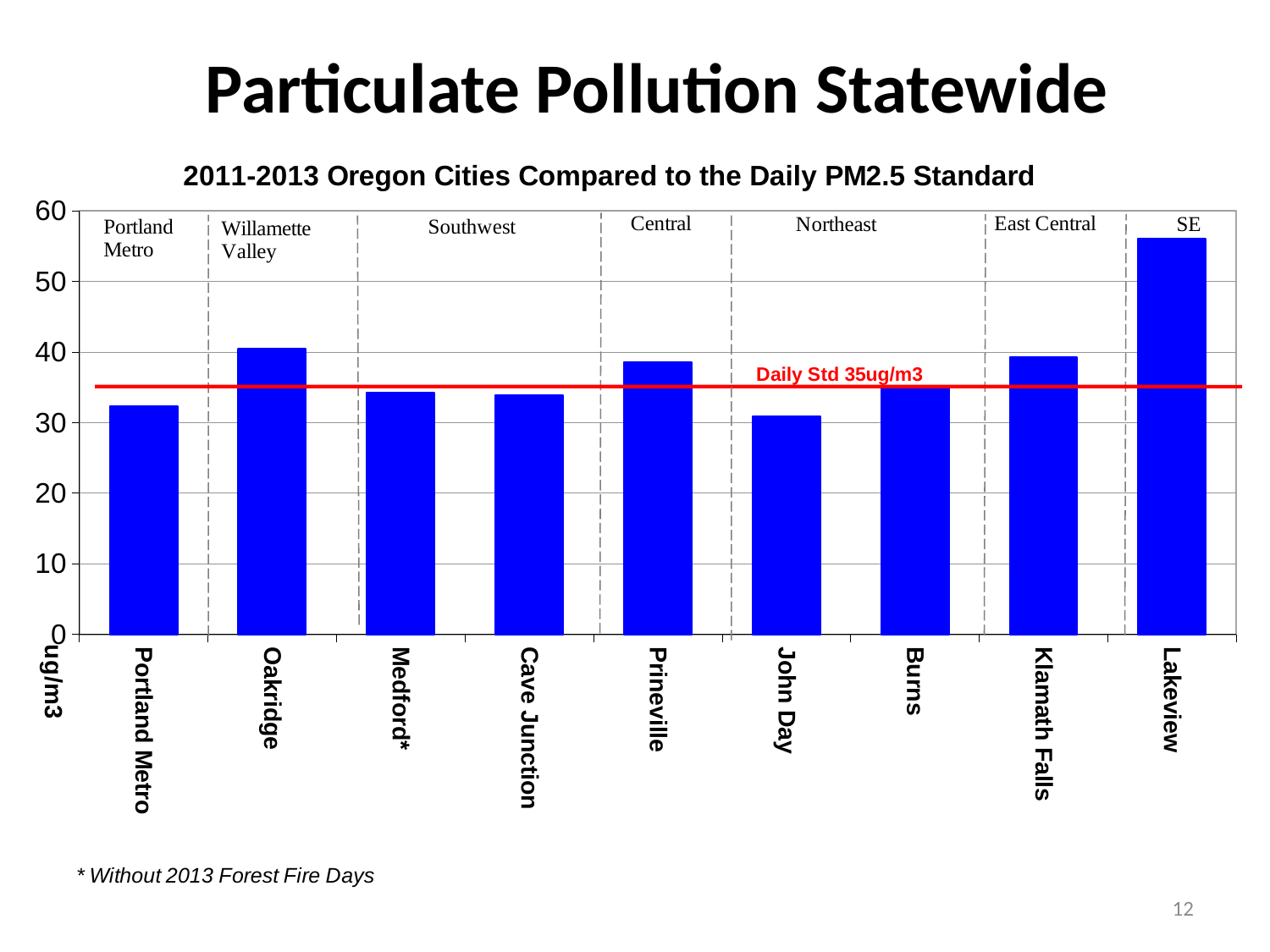
Which has a higher value, Lakeview or Oakridge? Lakeview Is the value for Klamath Falls greater or less than 35? greater Which city has the lowest PM2.5 value in the chart? John Day What is the title of the chart? 2011-2013 Oregon Cities Compared to the Daily PM2.5 Standard How many cities are plotted in the chart? 9 Is the value for John Day greater or less than 35? less What kind of chart is shown on the slide? bar chart What value does the red horizontal line labelled Daily Std represent? 35ug/m3 Which has a higher value, Prineville or Portland Metro? Prineville Is the value for Portland Metro greater or less than 40? less Which city has the highest PM2.5 value in the chart? Lakeview